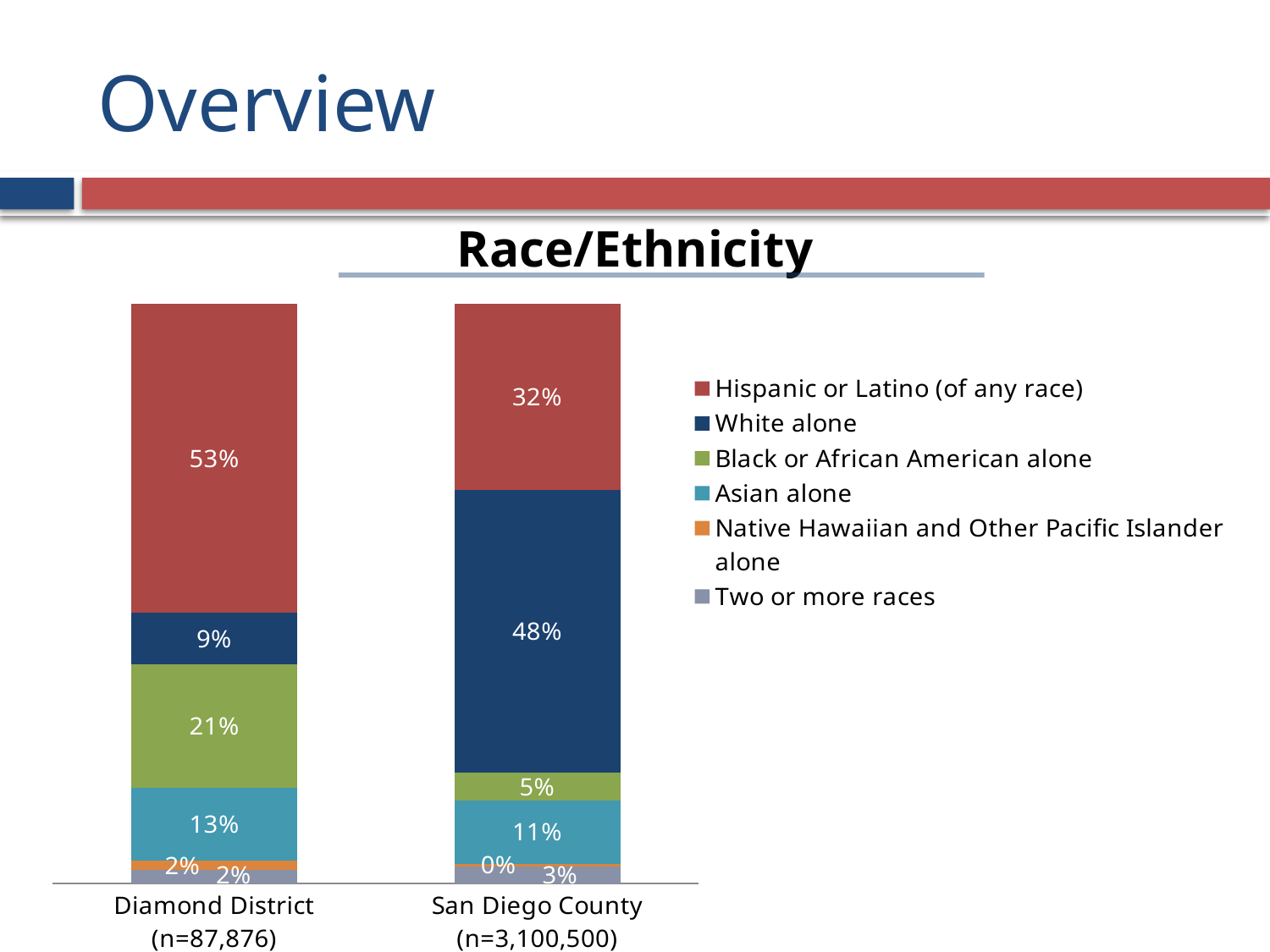
What kind of chart is shown on the slide? Stacked bar chart Which series is the largest segment in the Diamond District bar? Hispanic or Latino (of any race) What is the title of the chart? Race/Ethnicity What is the Native Hawaiian and Other Pacific Islander alone share for San Diego County? 0% What is the White alone share for San Diego County? 48% How many bars (categories) are shown in the chart? 2 What is the Black or African American alone share for Diamond District? 21% What is the Asian alone share for San Diego County? 11% Which category has the larger Hispanic or Latino (of any race) share, Diamond District or San Diego County? Diamond District How many series does the legend list? 6 What is the Hispanic or Latino (of any race) share for Diamond District? 53% What is the difference between the White alone share for San Diego County and for Diamond District? 39%